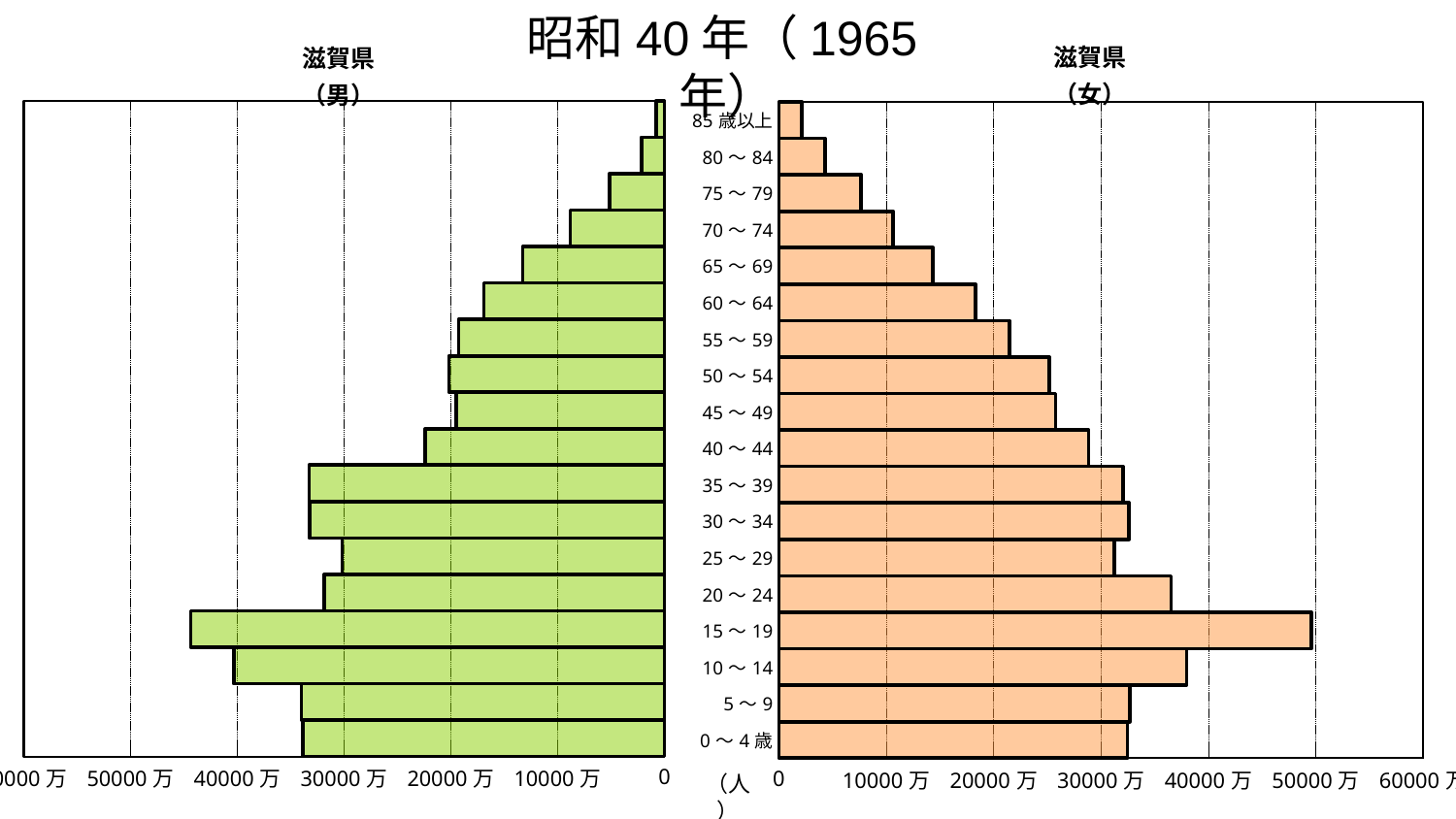
What is the title of the slide? 昭和 40 年（1965 年） What kind of chart is shown on the slide? bar chart In the 滋賀県（男） chart, which age group has the highest value? 15～19 In the 滋賀県（女） chart, which is larger, the value for 15～19 or the value for 10～14? 15～19 In the 滋賀県（男） chart, is the value for 15～19 greater or less than 40000万? greater In the 滋賀県（女） chart, is the value for 60～64 greater or less than 20000万? less How many age categories are plotted in the 滋賀県（男） chart? 18 In the 滋賀県（女） chart, is the value for 15～19 greater or less than 40000万? greater In the 滋賀県（女） chart, which age group has the lowest value? 85歳以上 In the 滋賀県（女） chart, which age group has the highest value? 15～19 In the 滋賀県（男） chart, which age group has the lowest value? 85歳以上